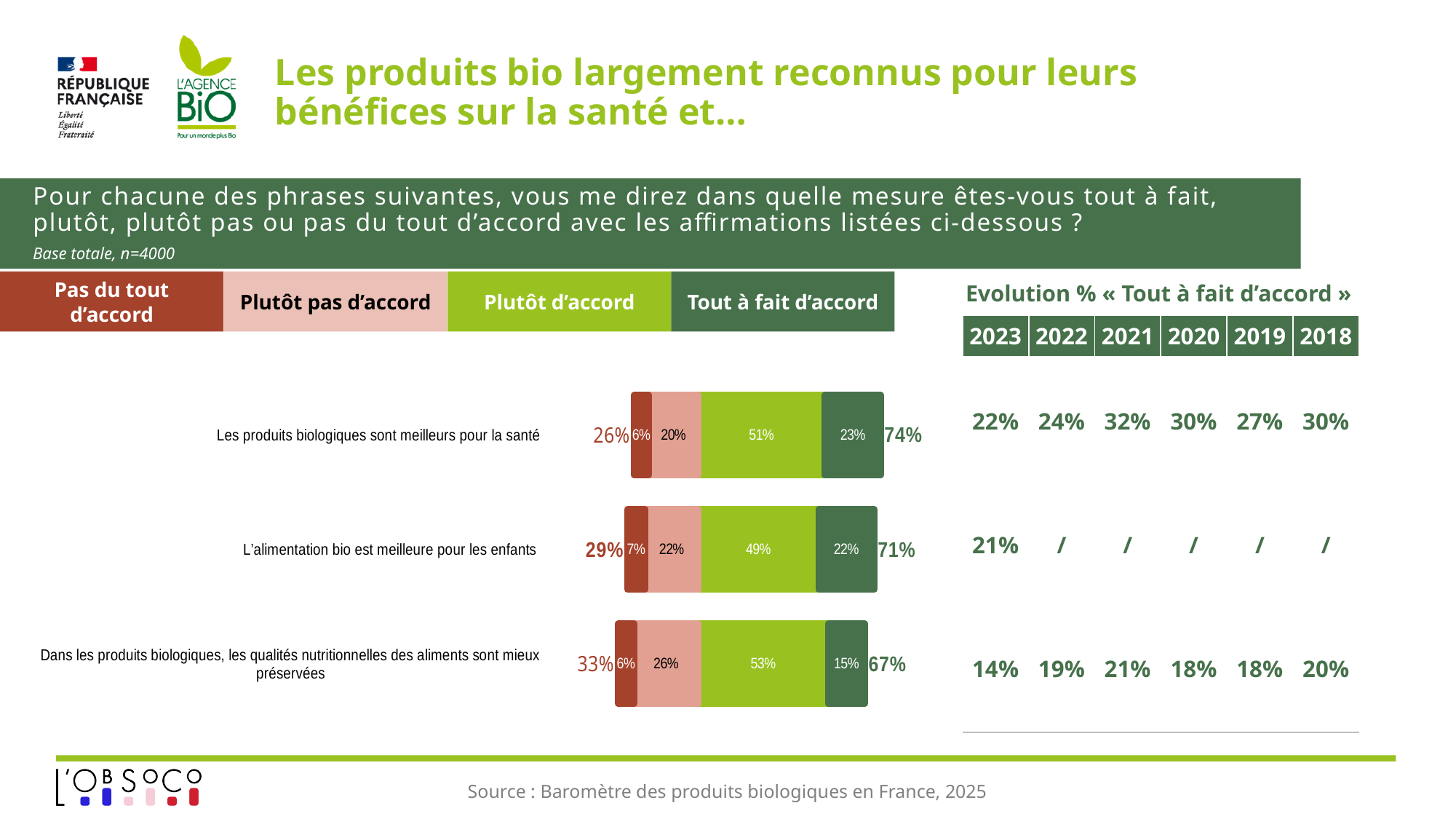
In the evolution table, what was the "Tout à fait d'accord" share in 2021 for "Les produits biologiques sont meilleurs pour la santé"? 32% What percentage of respondents answered "Tout à fait d'accord" to "Les produits biologiques sont meilleurs pour la santé"? 23% What is the difference between the "Plutôt d'accord" shares for "Dans les produits biologiques, les qualités nutritionnelles des aliments sont mieux préservées" and "L'alimentation bio est meilleure pour les enfants"? 4 percentage points Which is larger: the "Plutôt pas d'accord" share for "Les produits biologiques sont meilleurs pour la santé" or for "L'alimentation bio est meilleure pour les enfants"? L'alimentation bio est meilleure pour les enfants How many response categories does the legend list? 4 What kind of chart is used to show the responses? Stacked bar chart What percentage of respondents answered "Plutôt d'accord" to "Dans les produits biologiques, les qualités nutritionnelles des aliments sont mieux préservées"? 53% Which statement has the lowest "Tout à fait d'accord" share in the bar chart? Dans les produits biologiques, les qualités nutritionnelles des aliments sont mieux préservées How many statements are shown in the bar chart? 3 Which statement has the highest "Tout à fait d'accord" share in the bar chart? Les produits biologiques sont meilleurs pour la santé What is the combined share of "Plutôt d'accord" and "Tout à fait d'accord" for "L'alimentation bio est meilleure pour les enfants"? 71% What percentage of respondents answered "Pas du tout d'accord" to "L'alimentation bio est meilleure pour les enfants"? 7%